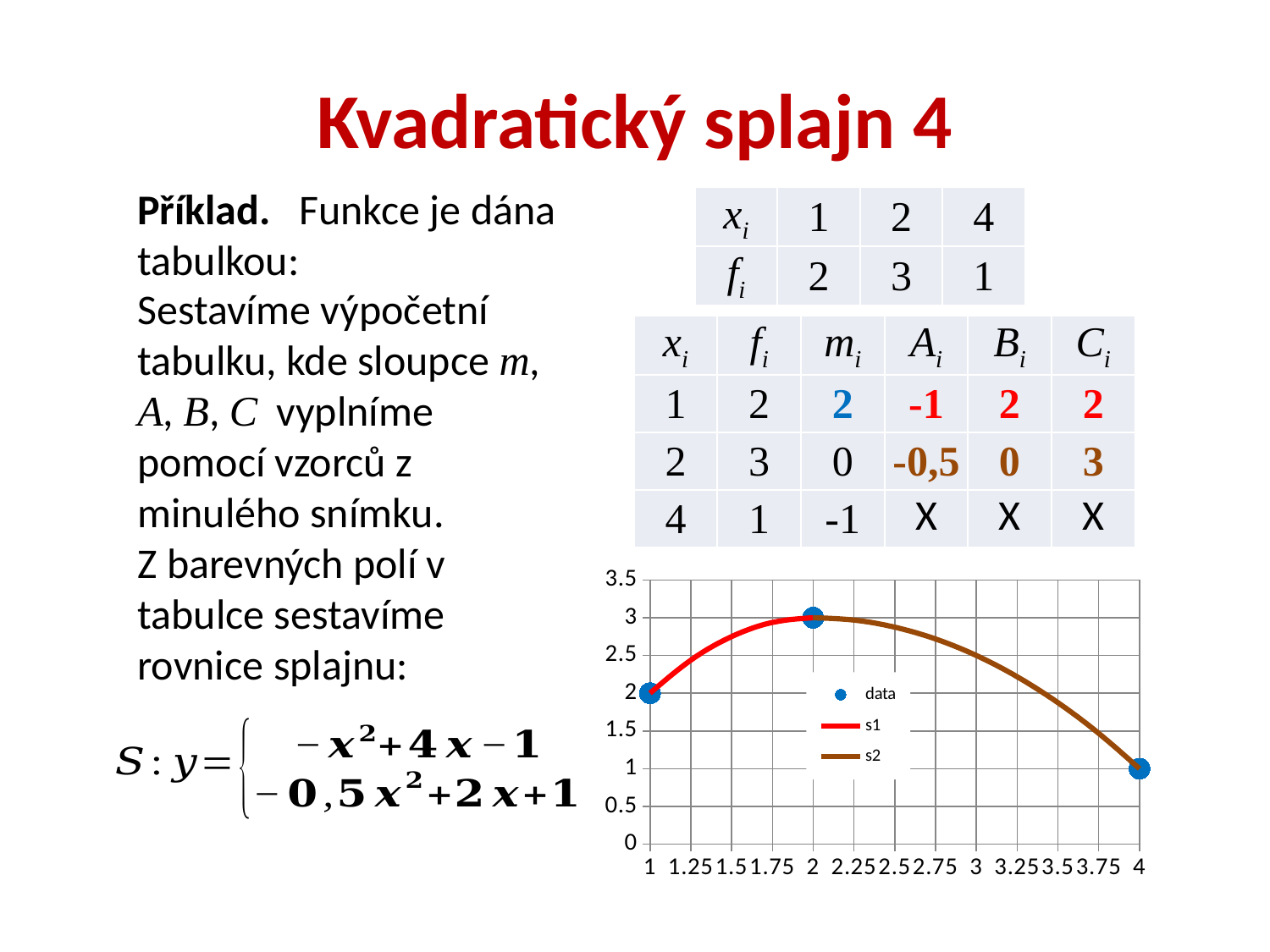
At which x value is the plotted data point highest? 2 What is the value of the data point at x = 4? 1 What is the difference between the data values at x = 2 and x = 4? 2 What kind of chart is shown on the slide? line chart At which x value is the plotted data point lowest? 4 Which data point has the larger value, the one at x = 1 or the one at x = 4? x = 1 Do the values of the s2 curve rise or fall as x goes from 2 to 4? fall How many series does the chart legend list? 3 How many data points are plotted in the chart? 3 What colour is the s1 series in the chart? red What is the value of the data point at x = 2? 3 Is the value of the s2 curve at x = 3 greater or less than 2? greater